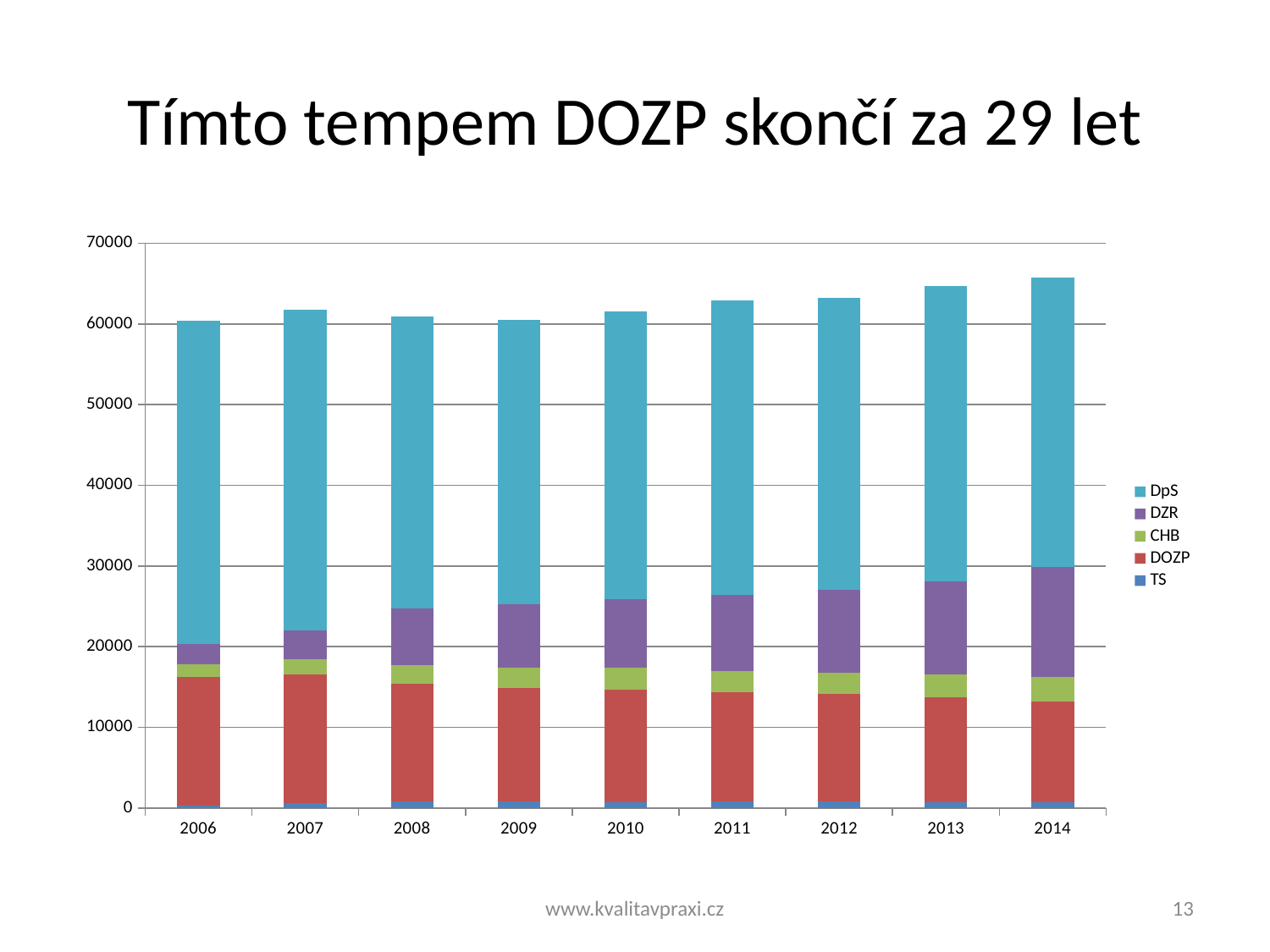
How many years are shown on the x axis of the chart? 9 Which year has the tallest total stacked bar? 2014 Is the total stacked value for 2014 greater or less than 60000? greater Which series appears at the top of each stacked bar? DpS Is the total stacked value for 2006 greater or less than 70000? less Which year has the larger total stacked bar, 2006 or 2014? 2014 How many series does the chart's legend list? 5 In 2014, which segment is larger, DpS or DOZP? DpS Is the total stacked value for 2011 greater or less than 60000? greater Does the DZR segment rise or fall from 2006 to 2014? rise Does the DOZP segment rise or fall from 2006 to 2014? fall What kind of chart is shown on the slide? bar chart